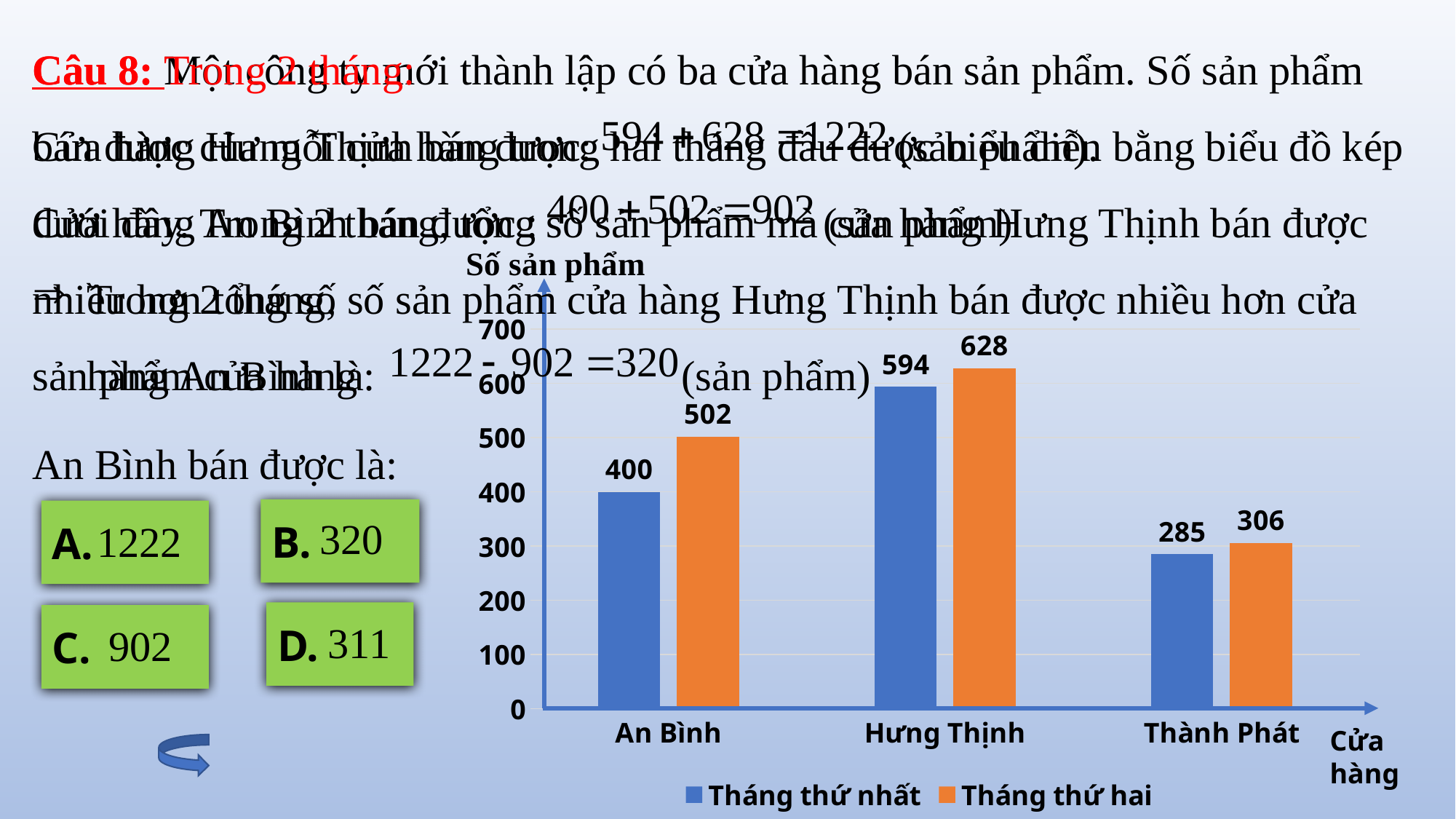
Which store has the highest value in the Tháng thứ hai series? Hưng Thịnh How many stores are shown on the x axis of the chart? 3 What is the value for An Bình in the Tháng thứ nhất series? 400 Is the Tháng thứ hai value for Thành Phát greater or less than 400? less Which is larger: the Tháng thứ nhất value for Hưng Thịnh or the Tháng thứ hai value for An Bình? Tháng thứ nhất value for Hưng Thịnh What is the value for Thành Phát in the Tháng thứ nhất series? 285 How many series does the chart legend list? 2 What kind of chart is shown on the slide? bar chart Which store has the lowest value in the Tháng thứ nhất series? Thành Phát What is the value for Hưng Thịnh in the Tháng thứ hai series? 628 What is the label of the vertical axis of the chart? Số sản phẩm What is the difference between the Tháng thứ hai and Tháng thứ nhất values for An Bình? 102